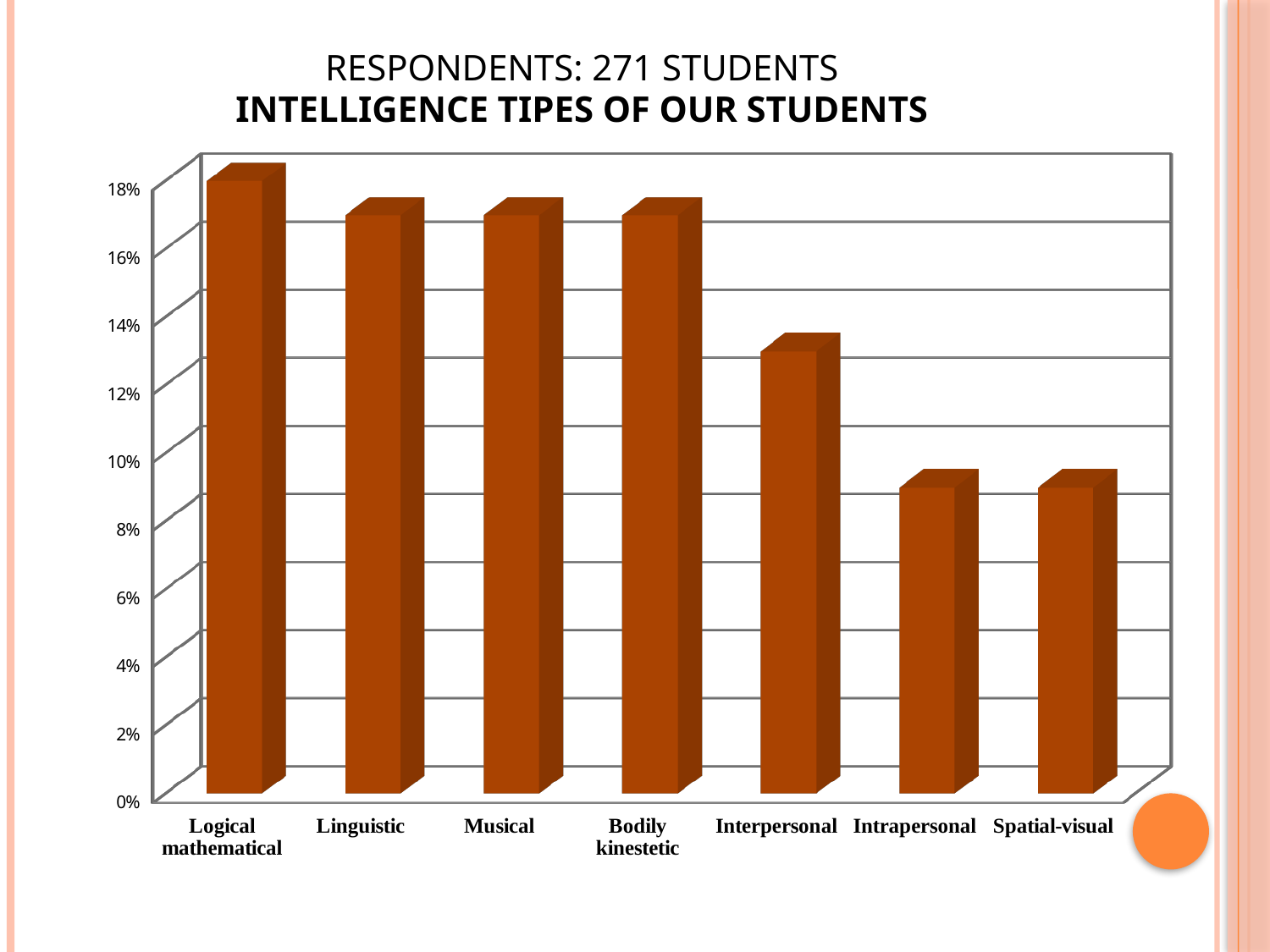
What kind of chart is shown on the slide? Bar chart Is the value for Interpersonal greater or less than 12%? greater Is the value for Spatial-visual greater or less than 10%? less How many students responded, according to the slide heading? 271 students Which is larger, the value for Bodily kinestetic or the value for Spatial-visual? Bodily kinestetic Do the values generally rise or fall moving from left to right along the x axis? fall Is the value for Interpersonal greater or less than 14%? less Which intelligence type has the highest value? Logical mathematical Which is larger, the value for Interpersonal or the value for Intrapersonal? Interpersonal How many intelligence types (categories) are shown on the x axis? 7